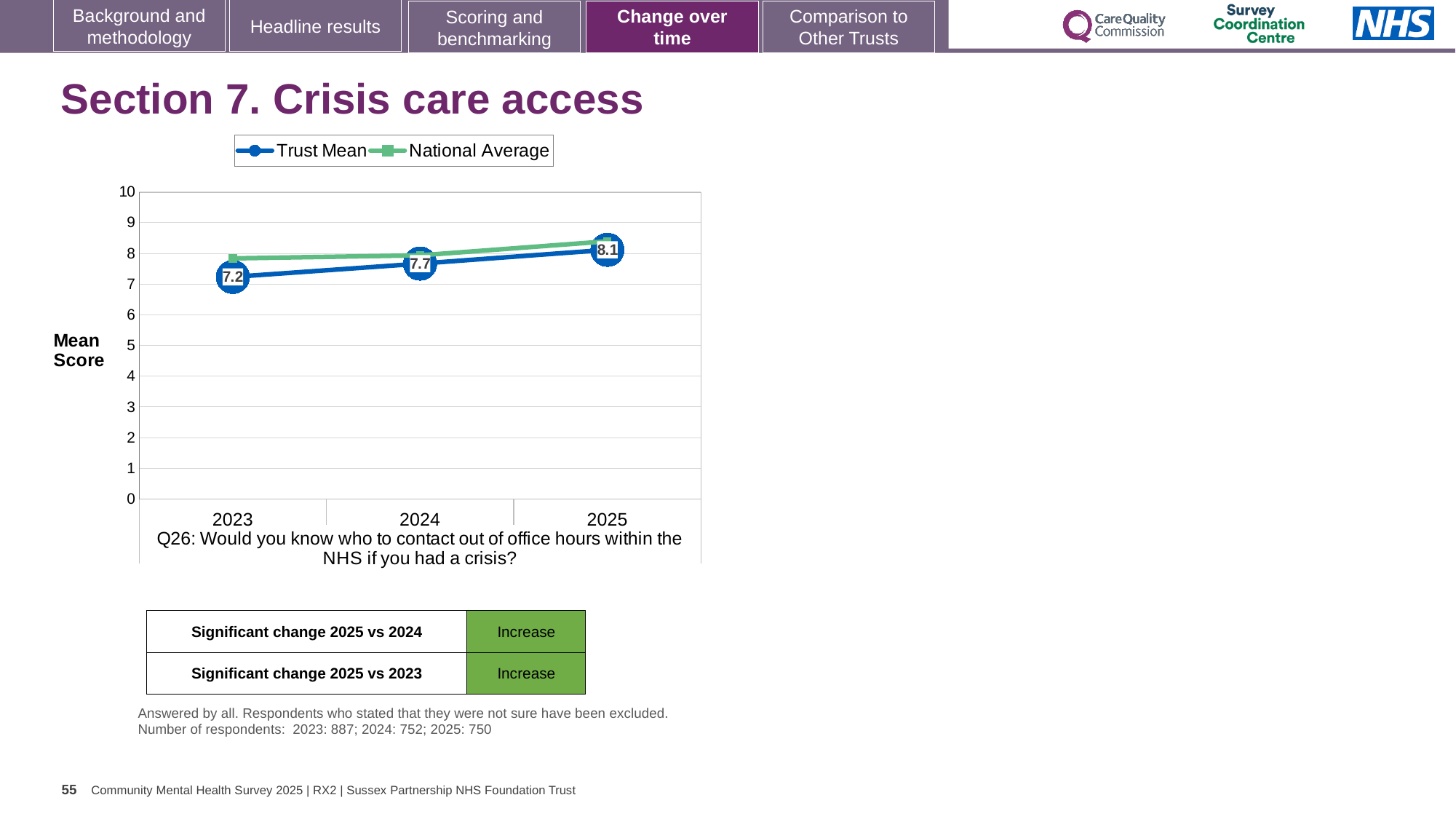
What is the difference between the Trust Mean in 2025 and in 2023? 0.9 What kind of chart is shown? line chart What is the Trust Mean for 2023? 7.2 Which is larger, the Trust Mean in 2024 or in 2023? 2024 Does the Trust Mean rise or fall from 2023 to 2025? rise How many years are shown on the x axis? 3 Is the National Average for 2025 greater or less than 8? greater In which year is the Trust Mean lowest? 2023 What is the Trust Mean for 2024? 7.7 In which year is the Trust Mean highest? 2025 How many series does the legend list? 2 What is the Trust Mean for 2025? 8.1